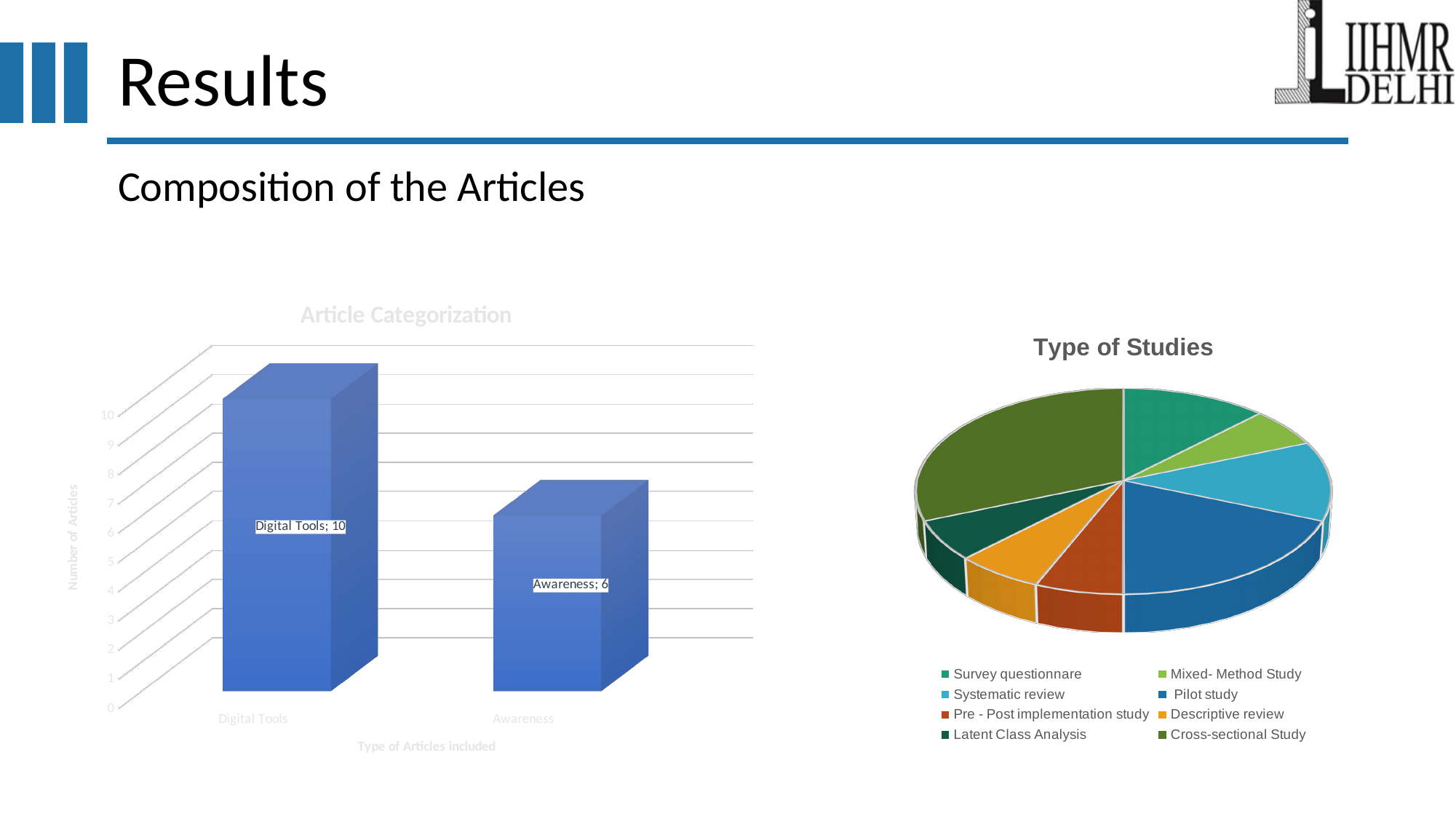
What kind of chart is the Article Categorization chart? Bar chart In the Article Categorization chart, how many articles are in the Digital Tools category? 10 In the Article Categorization chart, how many articles are in the Awareness category? 6 In the Type of Studies chart, which slice is larger: Pilot study or Mixed- Method Study? Pilot study What kind of chart is the Type of Studies chart? Pie chart In the Article Categorization chart, what is the title of the vertical axis? Number of Articles In the Article Categorization chart, how many categories are shown on the x axis? 2 In the Article Categorization chart, which category has the fewest articles? Awareness In the Type of Studies chart, how many study types does the legend list? 8 In the Article Categorization chart, which category has the most articles? Digital Tools In the Type of Studies chart, which study type has the largest slice? Cross-sectional Study In the Article Categorization chart, what is the difference between the number of Digital Tools articles and Awareness articles? 4